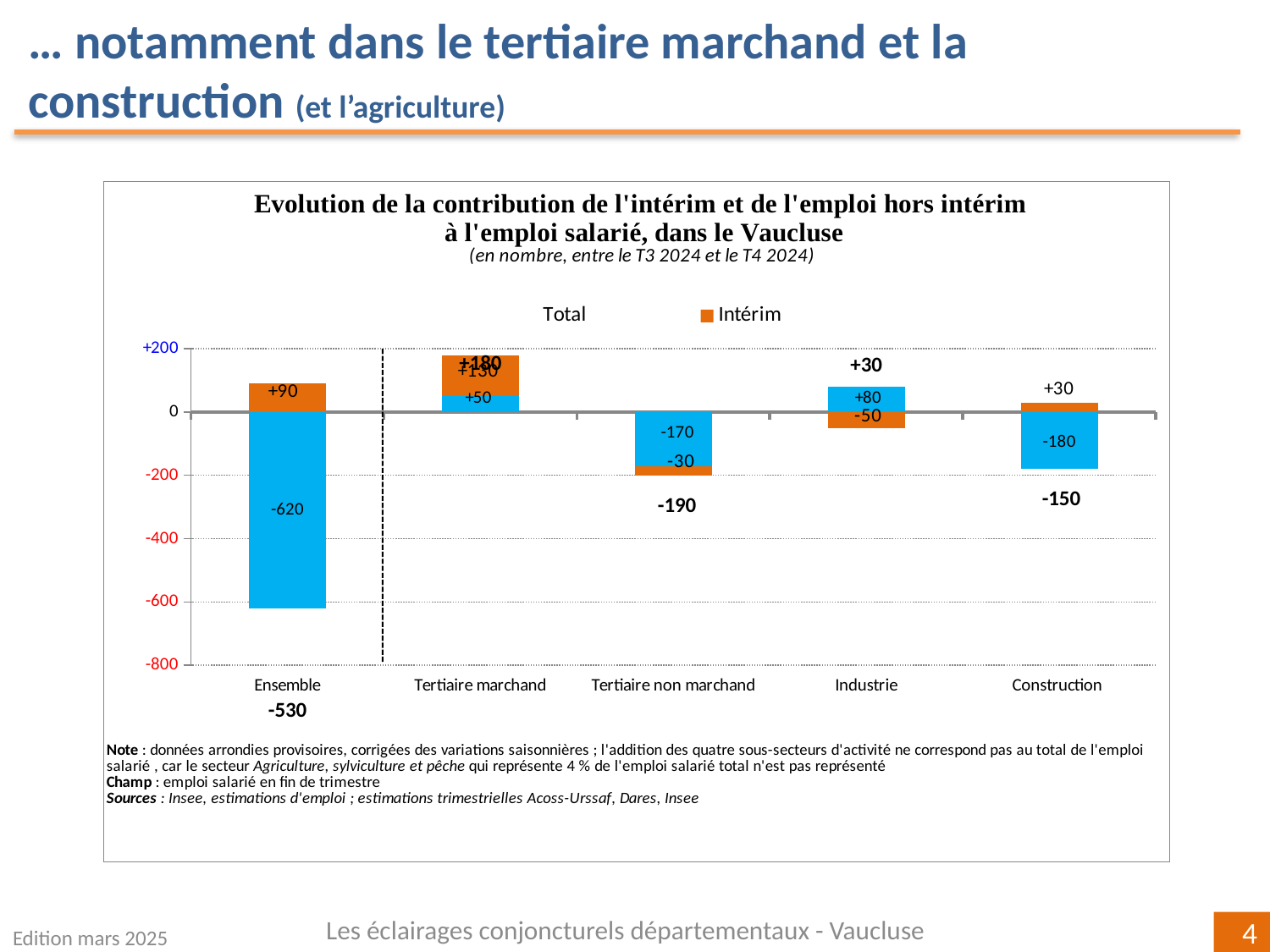
What is the Intérim value for Ensemble? +90 How many categories are shown on the x axis? 5 What total is shown for Construction? -150 What is the value of the blue (non-Intérim) bar for Ensemble? -620 What total is shown for Tertiaire non marchand? -190 What is the Intérim value for Industrie? -50 How many series does the legend list? 2 What is the difference between the total for Ensemble (-530) and the total for Tertiaire non marchand (-190)? 340 What total is shown for Ensemble? -530 What kind of chart is this? bar chart Which category has the lowest total? Ensemble Which is larger, the Intérim value for Construction or the Intérim value for Tertiaire non marchand? Construction